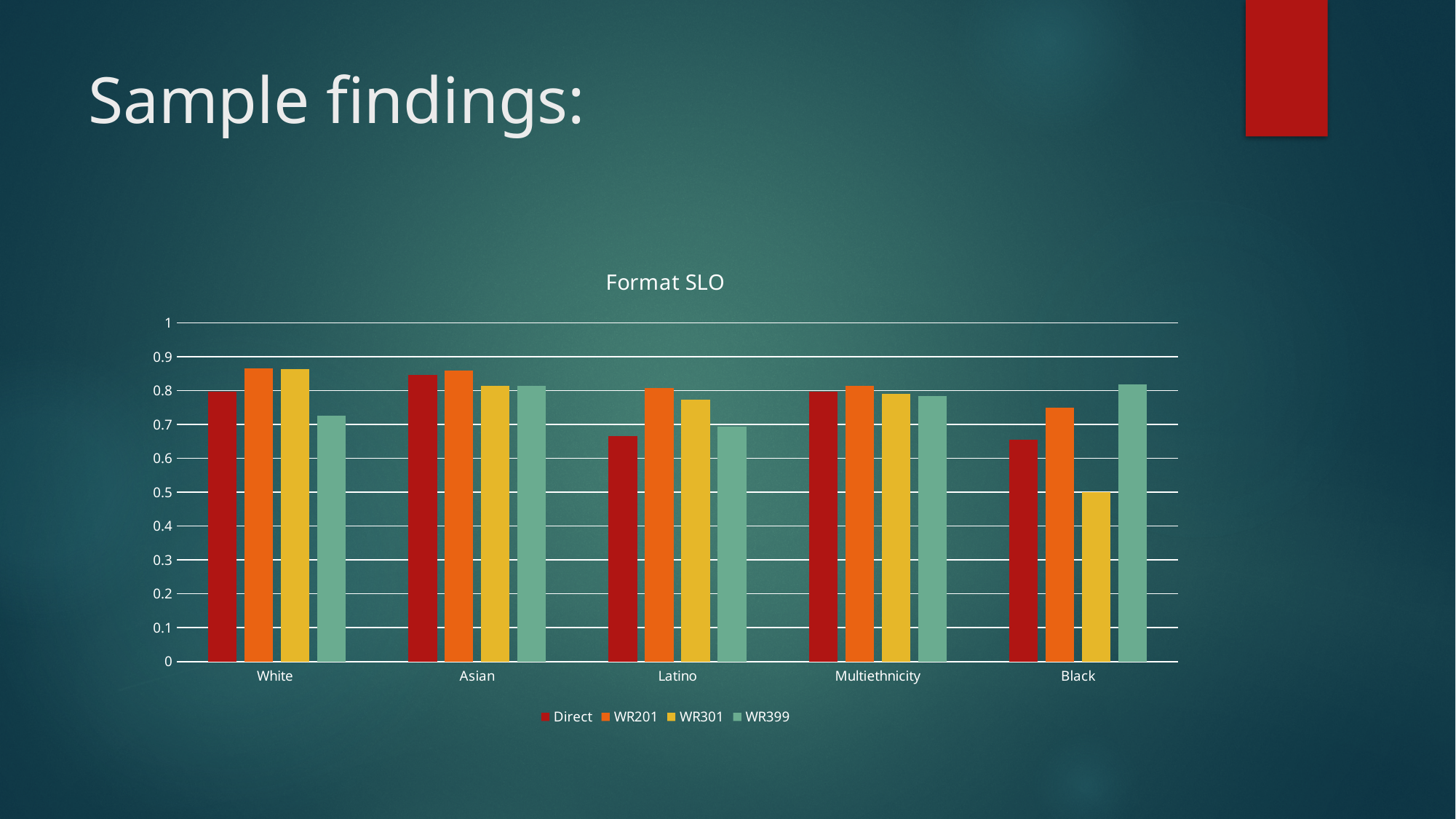
How many series does the legend list? 4 Which series has the lowest value for Black? WR301 Which series has the highest value for Black? WR399 What type of chart is shown on the slide? bar chart Is the value for WR399 for White greater or less than 0.8? less Which is larger, the WR301 value for White or the WR301 value for Black? White What is the title of the chart? Format SLO Which is larger, the Direct value for Asian or the Direct value for Latino? Asian Is the value for Direct for Latino greater or less than 0.7? less Is the value for WR201 for White greater or less than 0.8? greater How many categories are shown on the x axis? 5 Which series has the lowest value for White? WR399